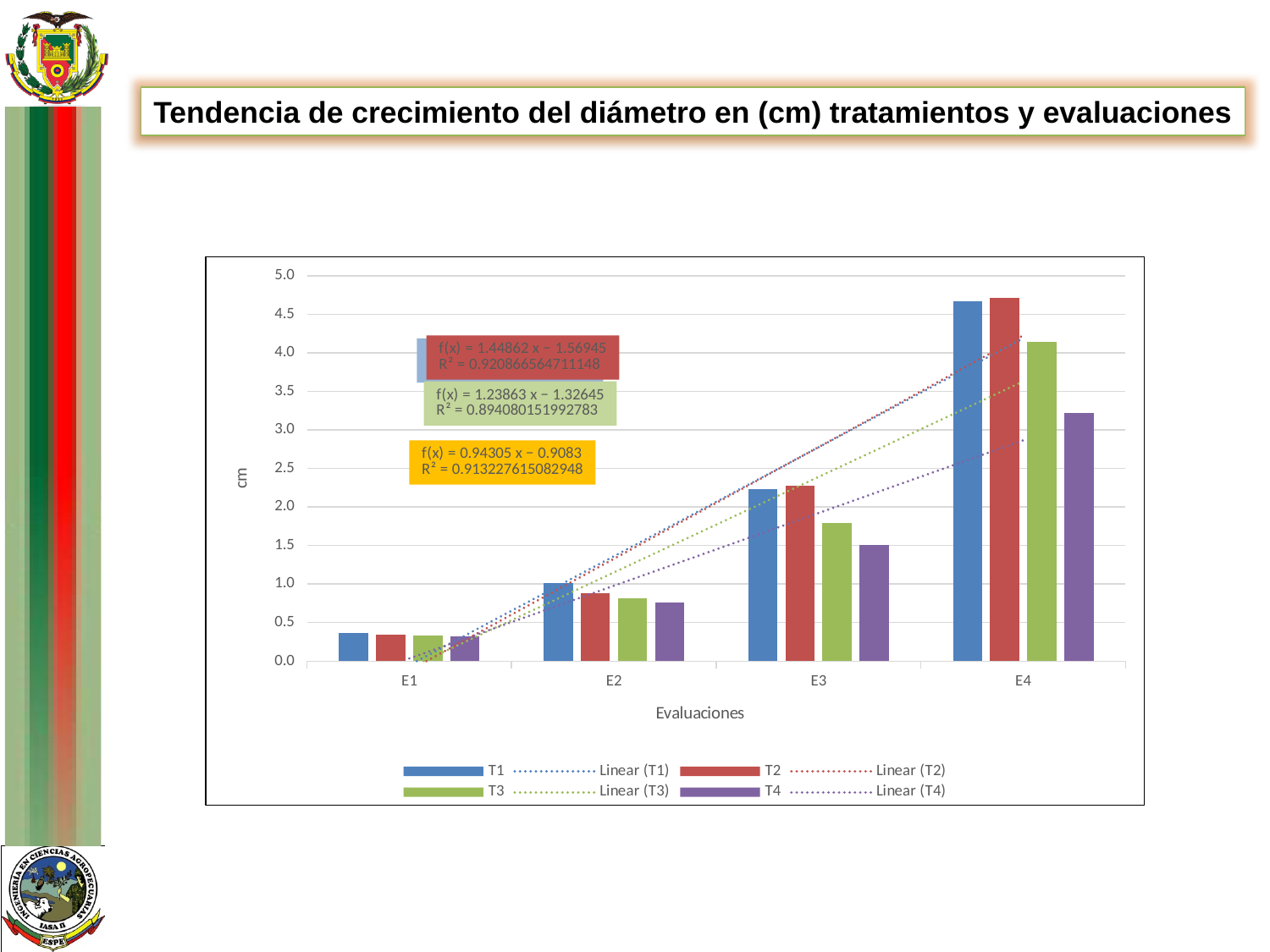
Do the values for T1 rise or fall from E1 to E4? rise Is the value for T4 at E3 greater or less than 2.0? less At E4, which is larger, T3 or T4? T3 Is the value for T1 at E1 greater or less than 0.5? less How many evaluation categories are shown on the x axis? 4 How many bar series (treatments) does the legend list? 4 Which treatment has the lowest value at E4? T4 What kind of chart is shown on the slide? bar chart Is the value for T4 at E2 greater or less than 1.0? less What is the label on the y axis of the chart? cm